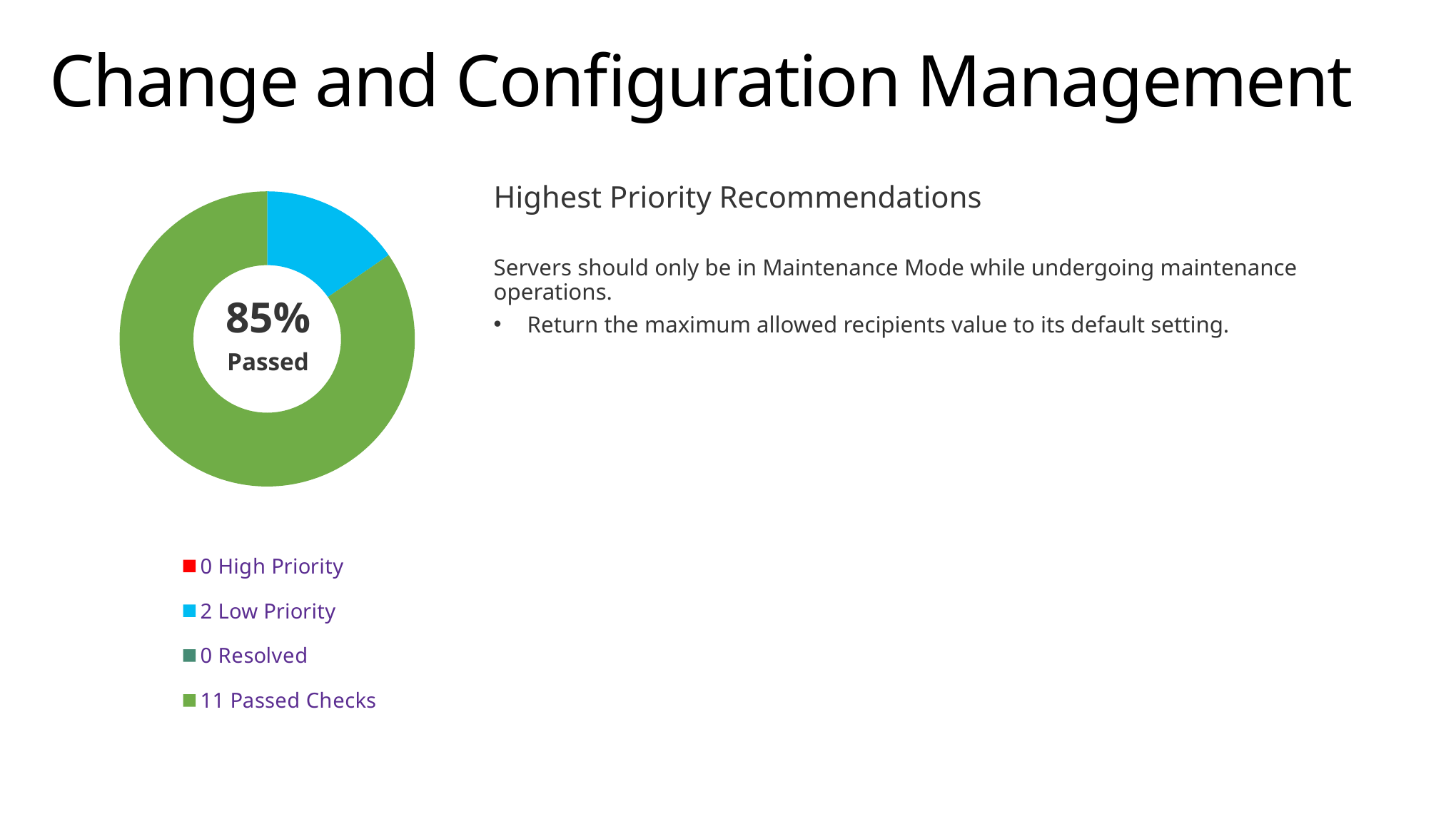
Which is larger, the number of Passed Checks or the number of Low Priority items? Passed Checks What word appears below the percentage in the centre of the chart? Passed How many Resolved items does the legend show? 0 What is the total of all the values listed in the legend? 13 What kind of chart is shown on the slide? Doughnut (pie) chart How many High Priority items does the legend show? 0 How many Passed Checks does the legend show? 11 How many categories does the legend list? 4 Which category has the largest value in the chart? Passed Checks How many Low Priority items does the legend show? 2 What percentage is shown in the centre of the chart? 85% What is the difference between the number of Passed Checks and the number of Low Priority items? 9